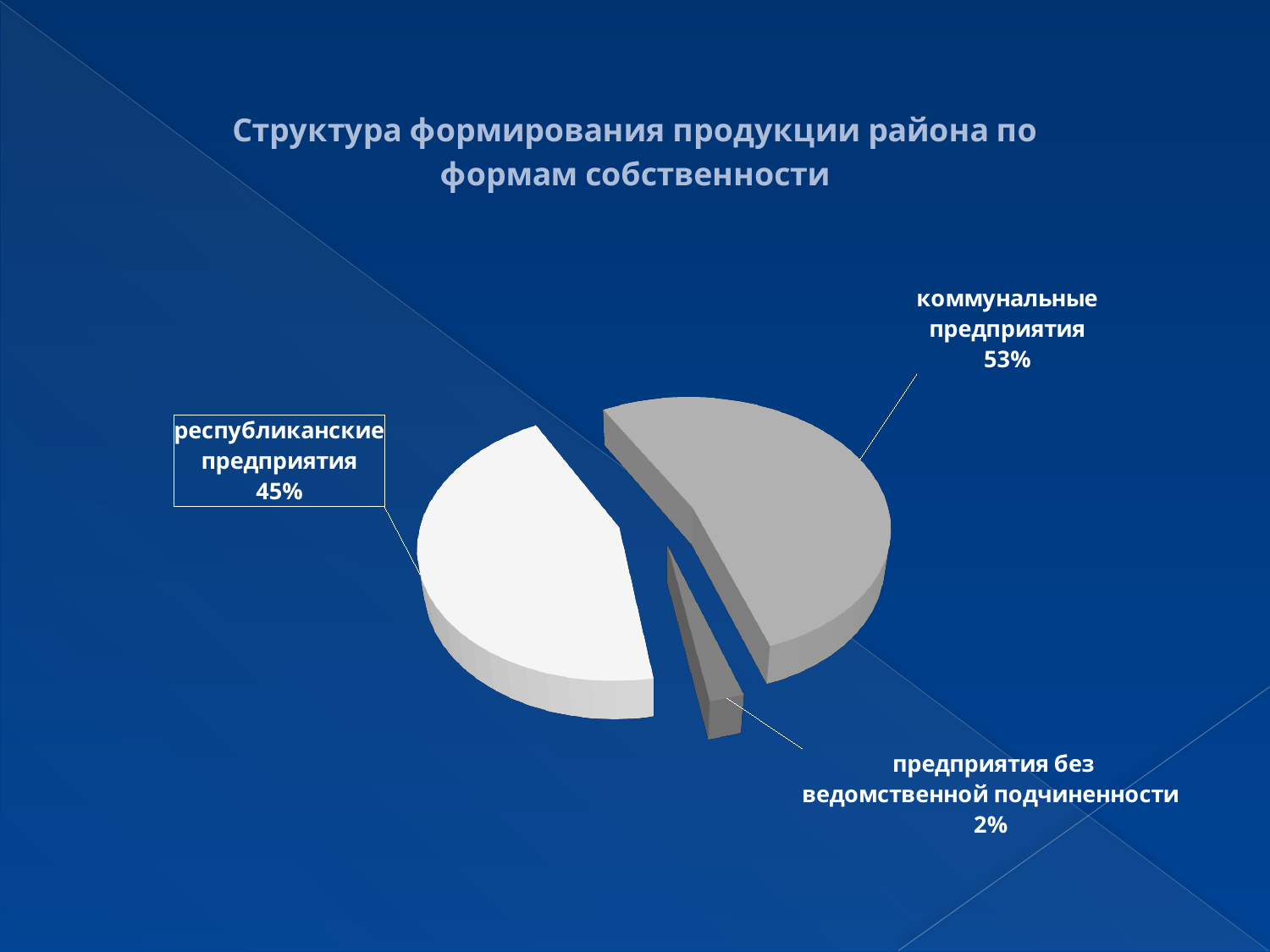
What share of the pie is labelled for республиканские предприятия? 45% How many categories are shown in the pie chart? 3 What share of the pie is labelled for предприятия без ведомственной подчиненности? 2% What is the title of the chart? Структура формирования продукции района по формам собственности What kind of chart is shown on the slide? pie chart What is the combined share of коммунальные предприятия and республиканские предприятия? 98% What share of the pie is labelled for коммунальные предприятия? 53% Which category has the smallest slice of the pie? предприятия без ведомственной подчиненности What is the difference in percentage points between коммунальные предприятия and республиканские предприятия? 8 Which category has the largest slice of the pie? коммунальные предприятия Which is larger: the share for республиканские предприятия or the share for предприятия без ведомственной подчиненности? республиканские предприятия